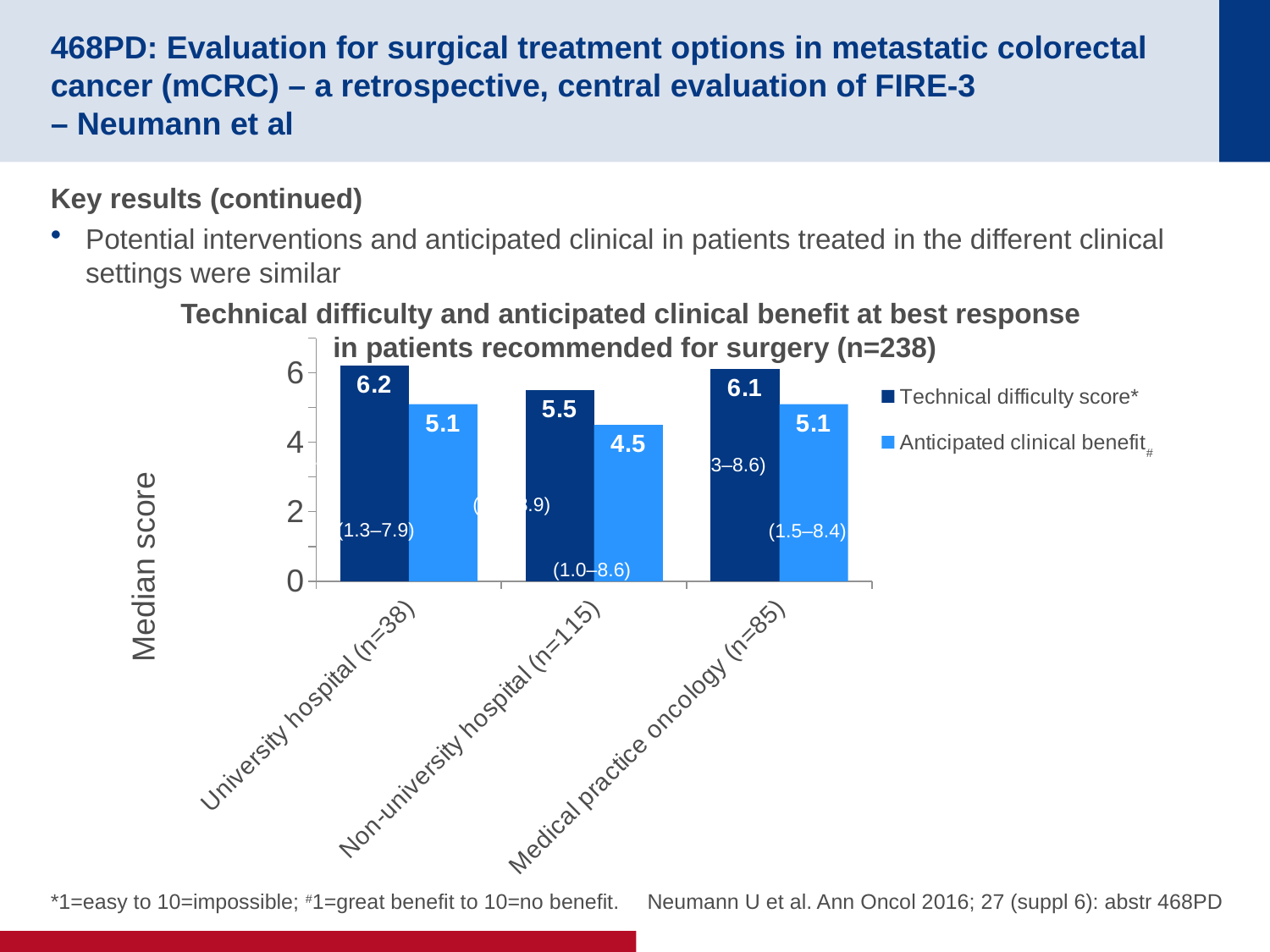
Which clinical setting has the lowest median technical difficulty score? Non-university hospital (n=115) How many series does the chart legend list? 2 Is the technical difficulty score higher for University hospital (n=38) or for Non-university hospital (n=115)? University hospital (n=38) What is the median technical difficulty score for Medical practice oncology (n=85)? 6.1 Which clinical setting has the highest median technical difficulty score? University hospital (n=38) Which clinical setting has the lowest median anticipated clinical benefit score? Non-university hospital (n=115) What is the difference between the technical difficulty score and the anticipated clinical benefit score for University hospital (n=38)? 1.1 What type of chart is used to show the median scores? Bar chart How many clinical settings are shown on the x axis of the chart? 3 What is the median technical difficulty score for University hospital (n=38)? 6.2 What is the median anticipated clinical benefit score for Medical practice oncology (n=85)? 5.1 What is the median anticipated clinical benefit score for Non-university hospital (n=115)? 4.5